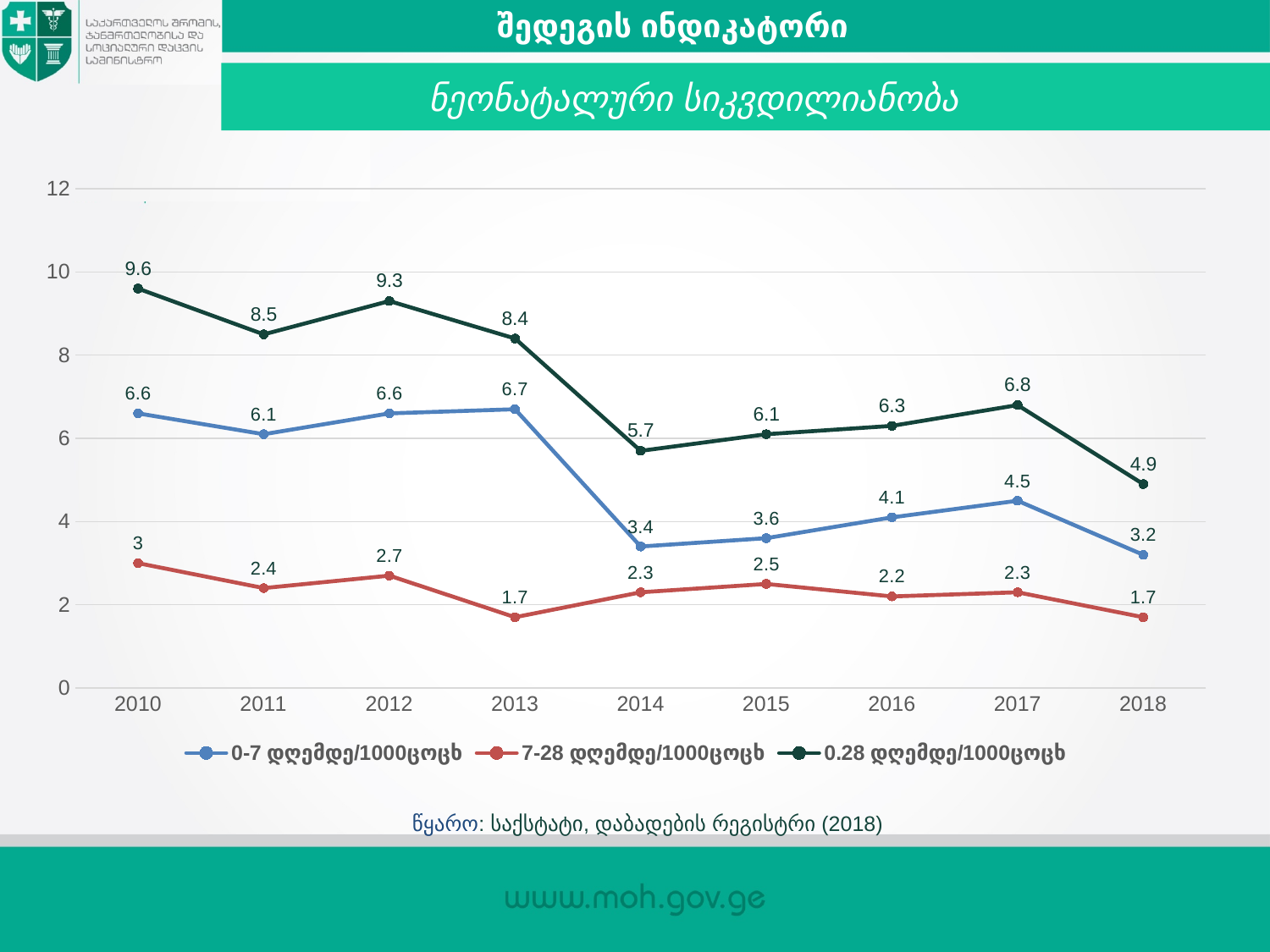
What is the value of the 7-28 დღემდე/1000ცოცხ series in 2018? 1.7 How many years are shown on the x axis? 9 What is the value of the 0.28 დღემდე/1000ცოცხ series in 2010? 9.6 In which year is the 0-7 დღემდე/1000ცოცხ series at its highest? 2013 What colour is the line for the 7-28 დღემდე/1000ცოცხ series? red What is the value of the 0-7 დღემდე/1000ცოცხ series in 2014? 3.4 What is the difference between the 0.28 დღემდე/1000ცოცხ values in 2013 and 2014? 2.7 In which year is the 0.28 დღემდე/1000ცოცხ series at its lowest? 2018 What type of chart is shown on the slide? line chart Which is larger: the 0-7 დღემდე/1000ცოცხ value in 2017 or in 2018? 2017 Does the 0.28 დღემდე/1000ცოცხ series generally rise or fall from 2010 to 2018? fall How many series does the legend list? 3